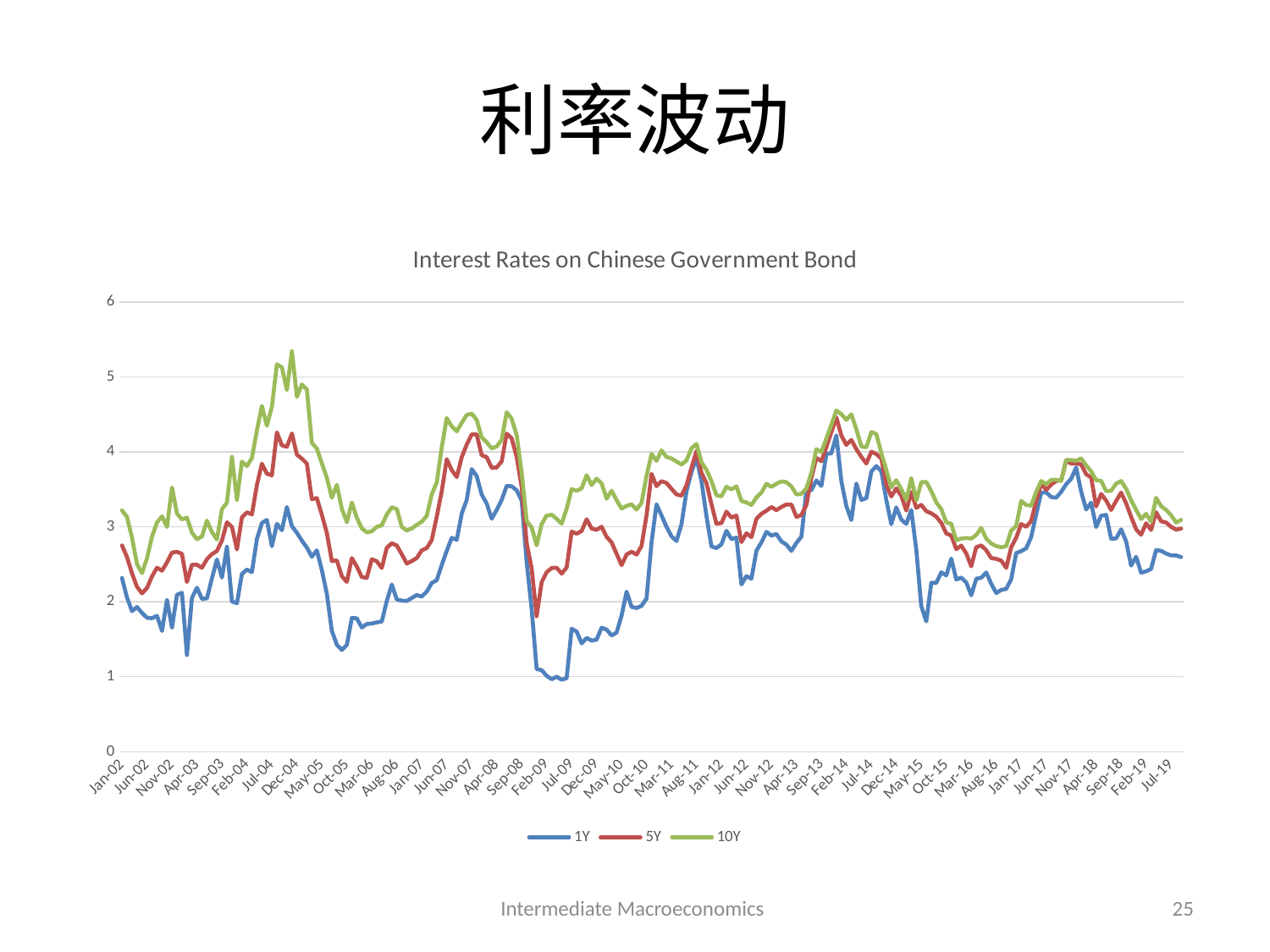
At Feb-14, which series is higher, 10Y or 1Y? 10Y What is the title of the chart? Interest Rates on Chinese Government Bond What kind of chart is shown on the slide? line chart Is the peak value of the 10Y series around Dec-04 greater or less than 5? greater Does the 1Y series rise or fall between Feb-14 and May-15? fall How many series does the legend list? 3 Which colour is used for the 10Y series? green Which series reaches the highest value anywhere on the chart? 10Y Which series reaches the lowest value anywhere on the chart? 1Y Is the value of the 1Y series at Jan-02 greater or less than 3? less Is the value of the 5Y series at Jul-19 greater or less than 4? less